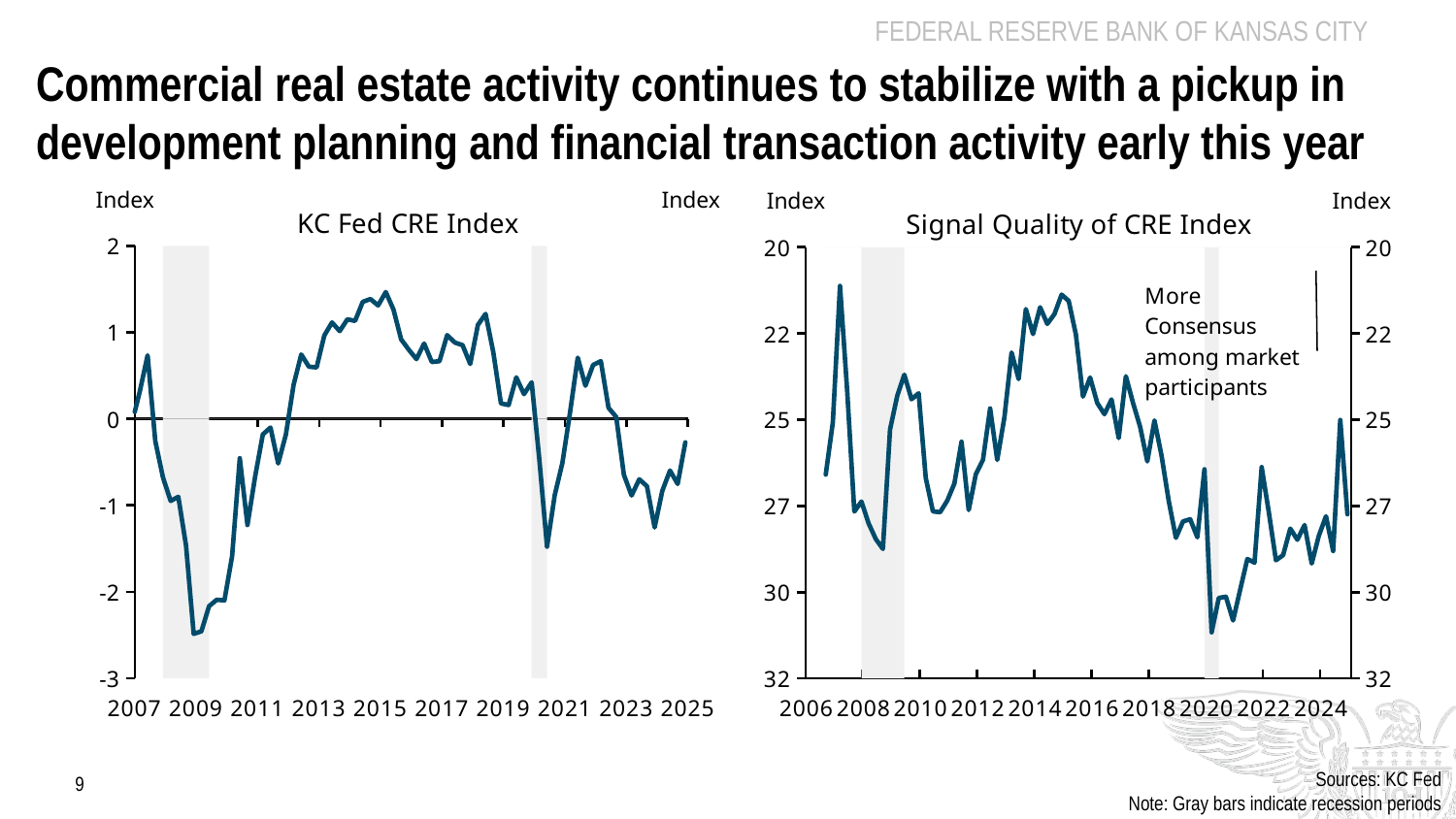
In the Signal Quality of CRE Index chart, is the value at the peak around 2007 greater or less than 22? less What kind of chart is the Signal Quality of CRE Index chart on the right? line chart In the KC Fed CRE Index chart, which year shows the lower index value, 2009 or 2015? 2009 In the KC Fed CRE Index chart, does the index rise or fall between 2009 and 2015? rise In the KC Fed CRE Index chart, is the lowest value reached around 2009 greater or less than -2? less What kind of chart is the KC Fed CRE Index chart on the left? line chart In the KC Fed CRE Index chart, is the peak value reached around 2015 greater or less than 1? greater How many charts are shown on the slide? 2 What is the title of the chart on the right? Signal Quality of CRE Index According to the note on the slide, what do the gray bars in the charts indicate? Recession periods